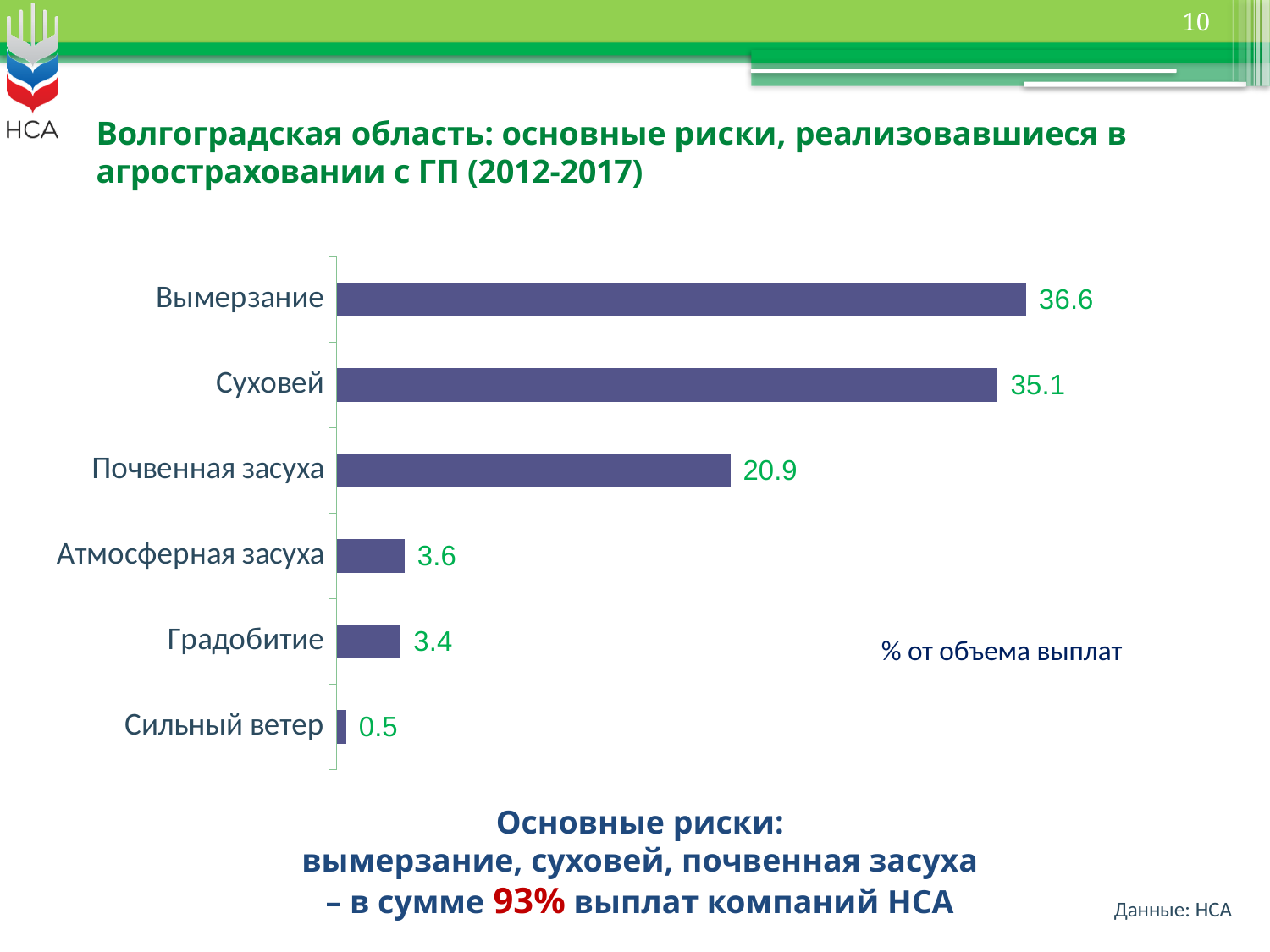
What kind of chart is shown on the slide? Bar chart What is the difference between the values for Суховей and Почвенная засуха? 14.2 How many categories are shown in the chart? 6 What is the value for Сильный ветер? 0.5 What is the difference between the values for Вымерзание and Суховей? 1.5 What is the value for Градобитие? 3.4 Which category has the lowest value? Сильный ветер What is the value for Вымерзание? 36.6 What is the value for Почвенная засуха? 20.9 What unit label is shown next to the chart? % от объема выплат Which category has the highest value? Вымерзание Which is larger, the value for Атмосферная засуха or Градобитие? Атмосферная засуха